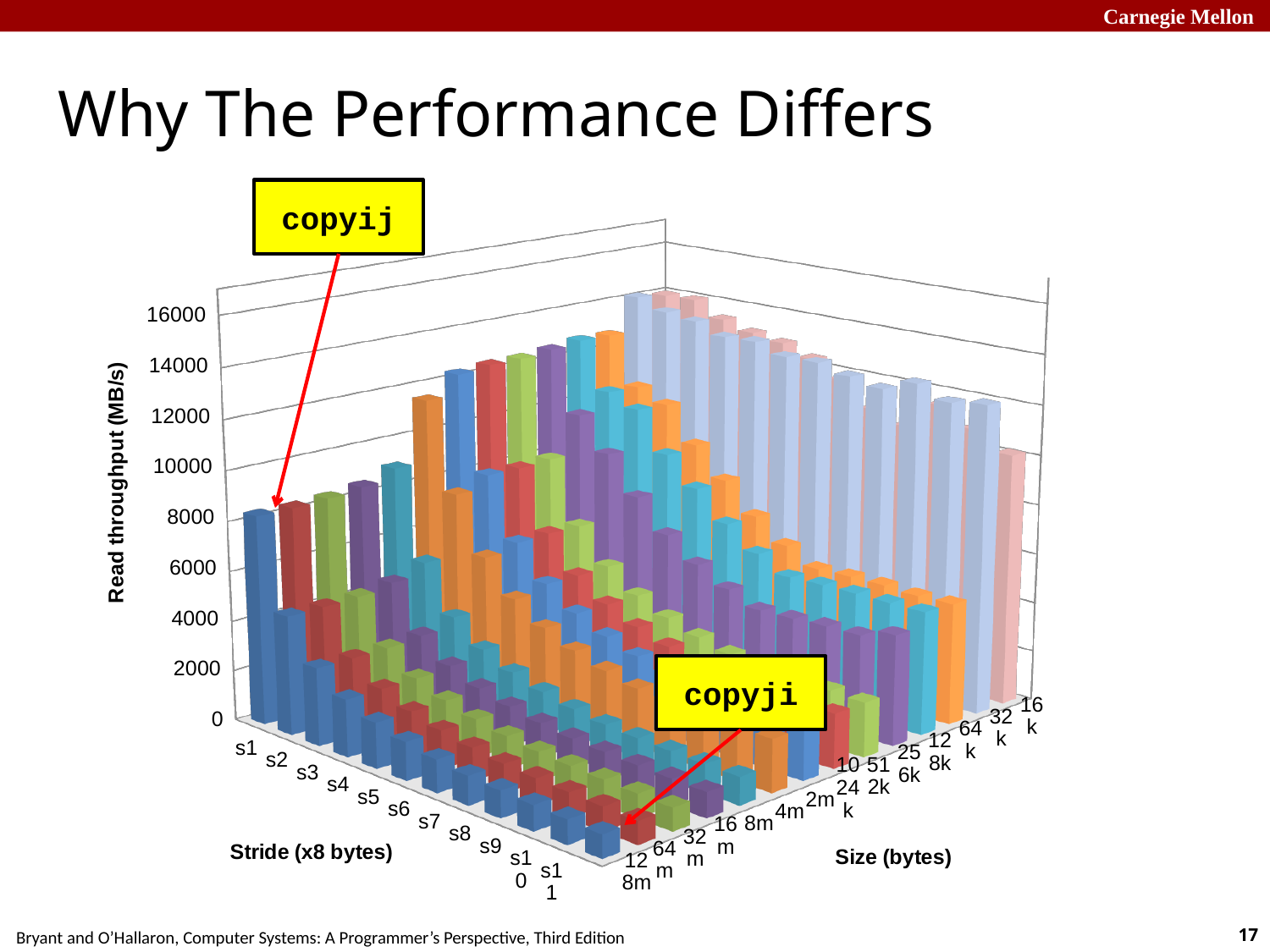
Is the read throughput for the bar labelled copyji greater or less than 4000? less What is the largest size category shown on the Size (bytes) axis? 128m What is the smallest size category shown on the Size (bytes) axis? 16k Which has the higher read throughput: stride s1 at size 128m or stride s11 at size 128m? stride s1 at size 128m Is the read throughput for stride s1 at size 32k greater or less than 12000? greater How many stride categories (s1 through s11) are shown on the chart? 11 What kind of chart is shown on the slide? 3D bar chart For the 128m size series, does read throughput rise or fall as stride increases from s1 to s11? fall What is the title of the vertical axis of the chart? Read throughput (MB/s) What is the label of the stride axis on the chart? Stride (x8 bytes) How many size categories are shown along the Size (bytes) axis? 14 What is the highest tick value shown on the Read throughput axis? 16000